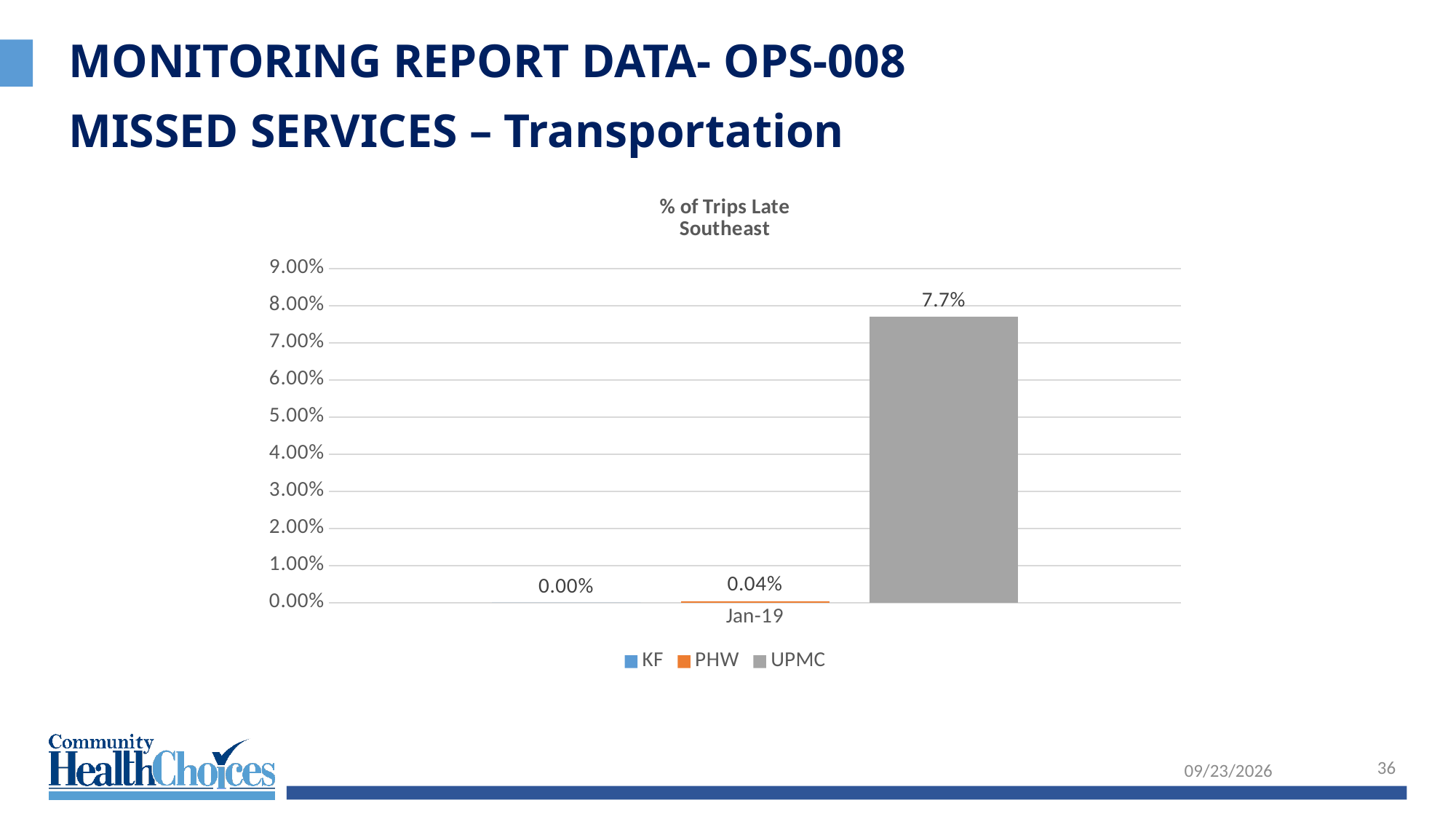
Which is larger in Jan-19, the value for PHW or the value for UPMC? UPMC Is the value for PHW in Jan-19 greater or less than 1.00%? less What is the value for UPMC in Jan-19? 7.7% What is the value for PHW in Jan-19? 0.04% What is the title of the chart? % of Trips Late Southeast Which series has the highest value in Jan-19? UPMC How many categories are shown on the x axis? 1 What is the value for KF in Jan-19? 0.00% What kind of chart is shown on the slide? bar chart Is the value for UPMC in Jan-19 greater or less than 7.00%? greater How many series does the legend list? 3 Which series has the lowest value in Jan-19? KF